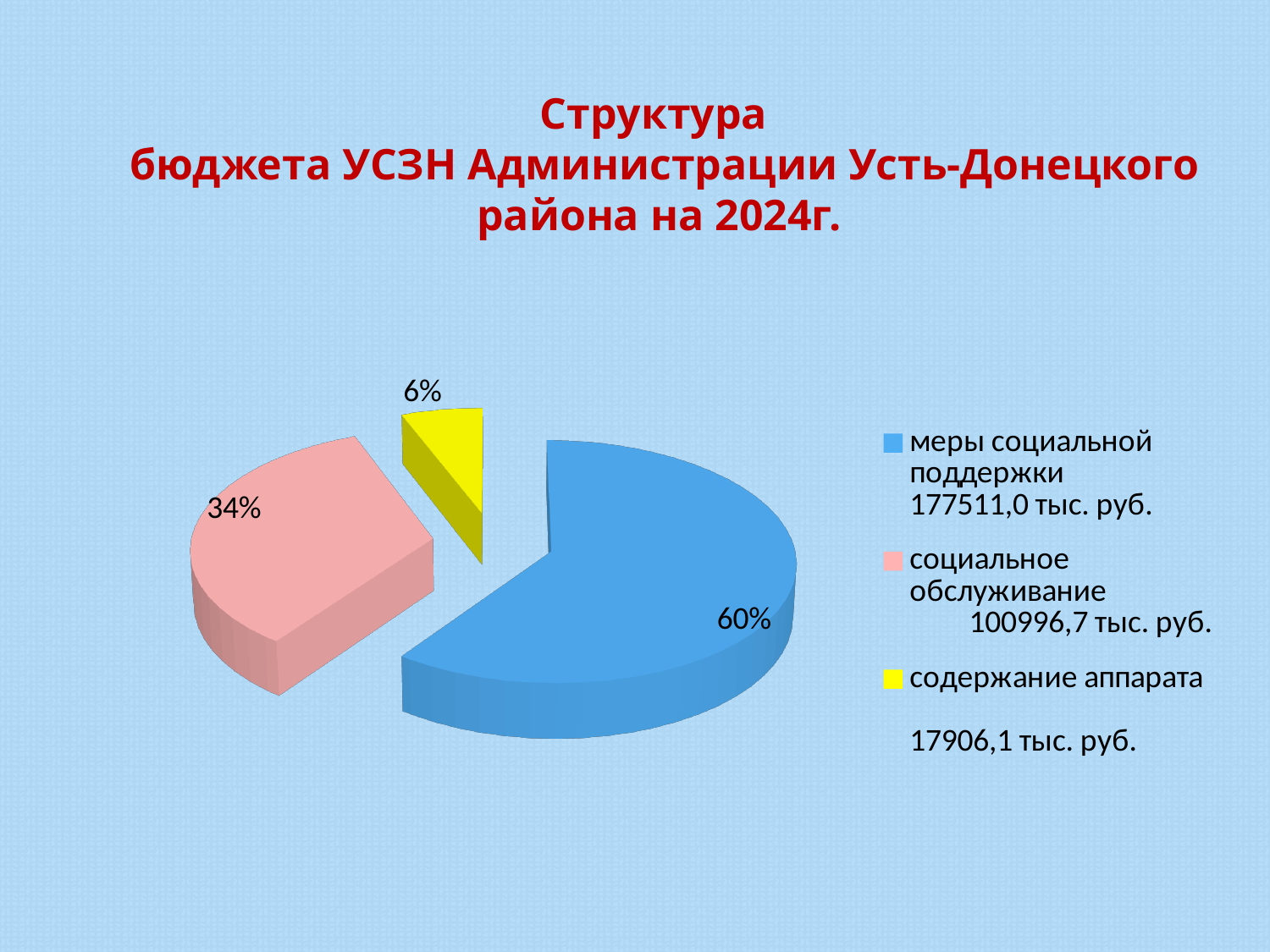
What kind of chart is shown on the slide? pie chart What amount in thousand rubles does the legend give for "меры социальной поддержки"? 177511,0 тыс. руб. What share of the pie does "содержание аппарата" take? 6% How many slices does the pie chart have? 3 How many entries does the legend list? 3 What colour is the slice for "содержание аппарата"? yellow Which slice is larger: "социальное обслуживание" or "содержание аппарата"? социальное обслуживание What share of the pie does "меры социальной поддержки" take? 60% Which category has the smallest slice of the pie? содержание аппарата What is the difference in percentage points between the "меры социальной поддержки" slice and the "социальное обслуживание" slice? 26 percentage points Which category has the largest slice of the pie? меры социальной поддержки What share of the pie does "социальное обслуживание" take? 34%